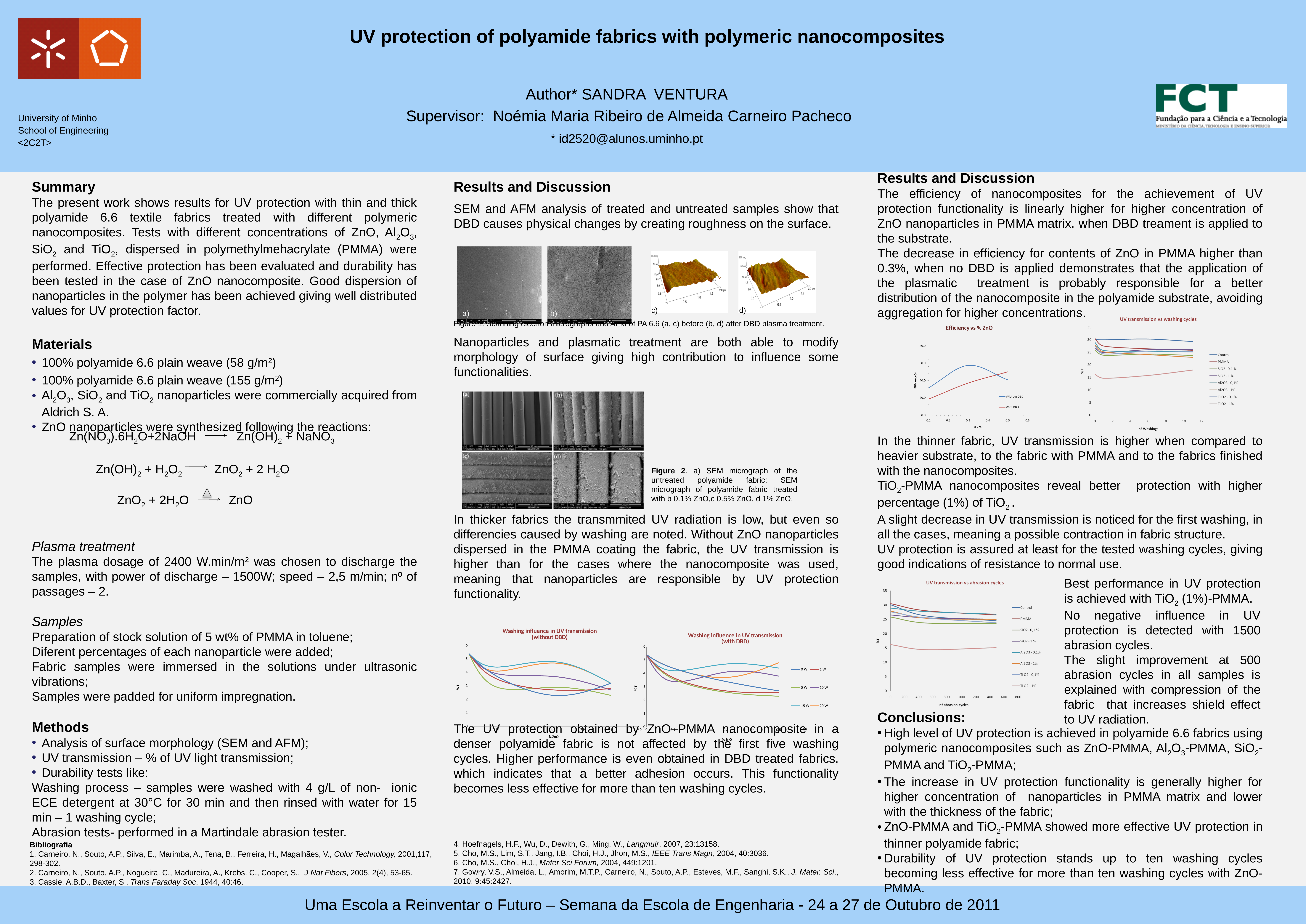
In the "UV transmission vs washing cycles" chart, is the value for Control at 0 washings greater or less than 25? greater In the "UV transmission vs washing cycles" chart, is the value for Ti O2 - 1% at 0 washings greater or less than 20? less What is the x-axis label of the "UV transmission vs abrasion cycles" chart? nº abrasion cycles In the "UV transmission vs abrasion cycles" chart, is the value for Control at 0 abrasion cycles greater or less than 25? greater In the "Efficiency vs % ZnO" chart, does the "With DBD" series rise or fall as % ZnO increases? rise In the "UV transmission vs abrasion cycles" chart, which series has the lowest UV transmission? Ti O2 - 1% How many series does the legend of the "UV transmission vs washing cycles" chart list? 8 What kind of chart is the "Efficiency vs % ZnO" chart? line chart What is the title of the chart at the bottom right of the poster, above the Conclusions? UV transmission vs abrasion cycles How many series does the legend of the "Washing influence in UV transmission (with DBD)" chart list? 6 How many series does the legend of the "Efficiency vs % ZnO" chart list? 2